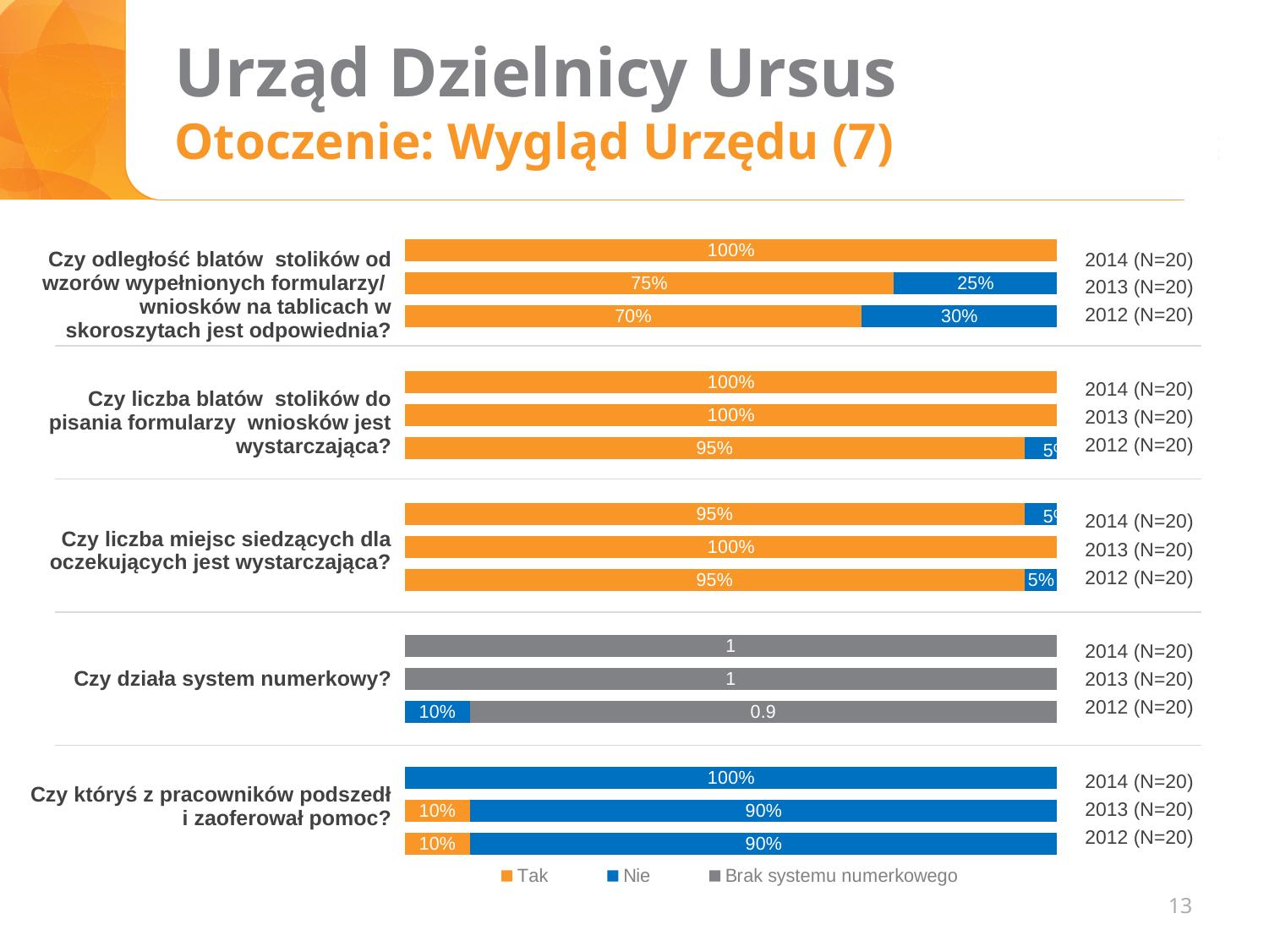
What kind of chart is used for "Czy działa system numerkowy?"? stacked bar chart In the chart for "Czy działa system numerkowy?", what is the Nie value for 2012 (N=20)? 10% In the chart for "Czy odległość blatów stolików od wzorów wypełnionych formularzy/wniosków na tablicach w skoroszytach jest odpowiednia?", what is the Nie value for 2012 (N=20)? 30% In the chart for "Czy działa system numerkowy?", what is the Brak systemu numerkowego value for 2012 (N=20)? 0.9 In the chart for "Czy odległość blatów stolików od wzorów wypełnionych formularzy/wniosków na tablicach w skoroszytach jest odpowiednia?", by how many percentage points does the Tak value for 2013 exceed the Tak value for 2012? 5 percentage points In the chart for "Czy liczba miejsc siedzących dla oczekujących jest wystarczająca?", what is the Nie value for 2012 (N=20)? 5% In the chart for "Czy liczba blatów stolików do pisania formularzy wniosków jest wystarczająca?", what is the Tak value for 2012 (N=20)? 95% In the chart for "Czy odległość blatów stolików od wzorów wypełnionych formularzy/wniosków na tablicach w skoroszytach jest odpowiednia?", what is the Tak value for 2013 (N=20)? 75% In the chart for "Czy odległość blatów stolików od wzorów wypełnionych formularzy/wniosków na tablicach w skoroszytach jest odpowiednia?", does the Tak share rise or fall from 2012 to 2014? rise In the chart for "Czy któryś z pracowników podszedł i zaoferował pomoc?", what is the Nie value for 2014 (N=20)? 100% How many series does the legend at the bottom of the slide list? 3 In the chart for "Czy któryś z pracowników podszedł i zaoferował pomoc?", what is the Nie value for 2013 (N=20)? 90%